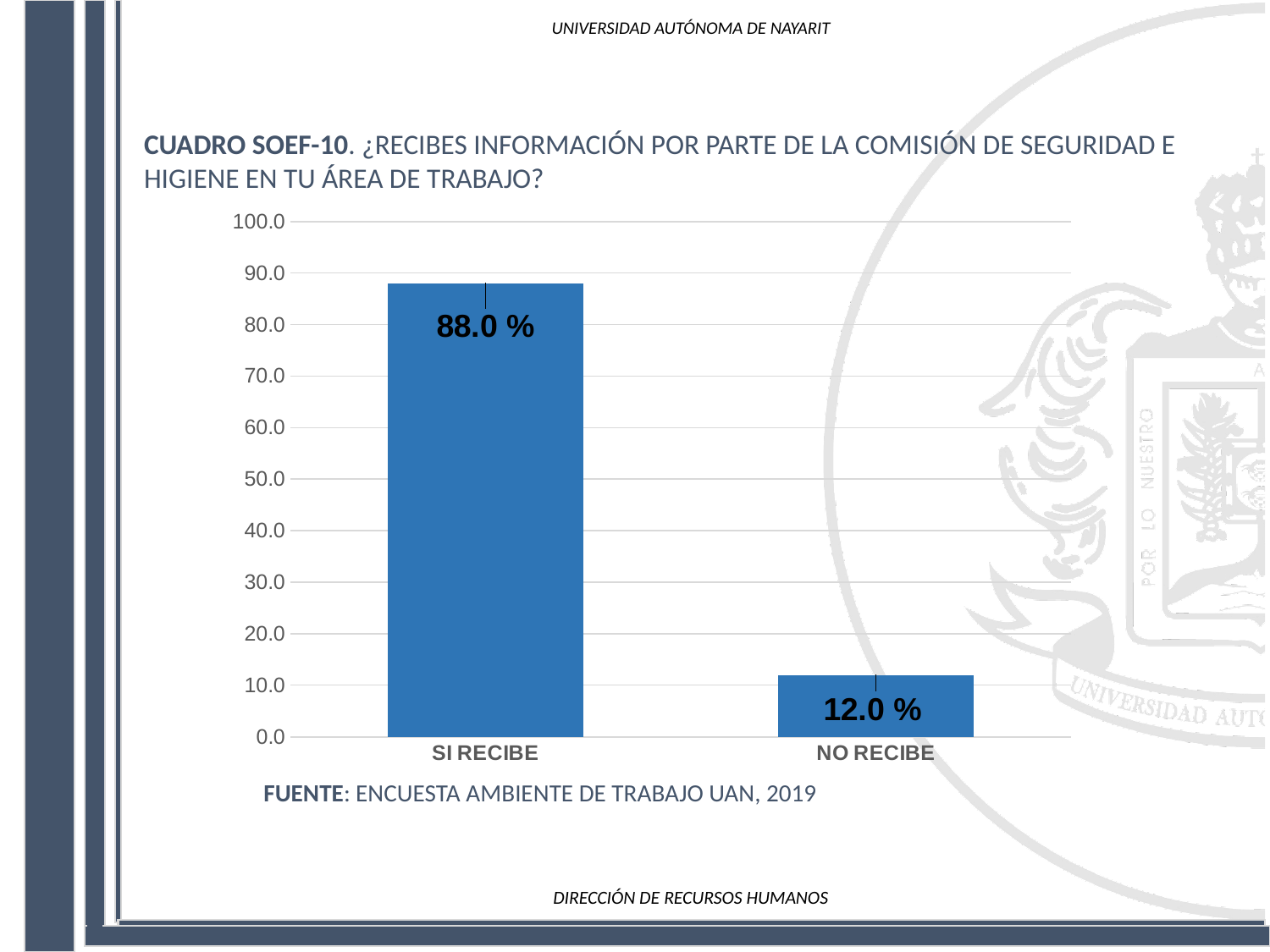
Which category has the lowest value? NO RECIBE Is the value for SI RECIBE greater or less than 80.0? greater What is the value for SI RECIBE? 88.0 % What is the difference between the values for SI RECIBE and NO RECIBE? 76.0 % What is the maximum value shown on the y axis? 100.0 Which category has the highest value? SI RECIBE What source is cited below the chart? ENCUESTA AMBIENTE DE TRABAJO UAN, 2019 What kind of chart is shown on the slide? bar chart Is the value for NO RECIBE greater or less than 20.0? less What is the value for NO RECIBE? 12.0 % How many categories are shown on the x axis? 2 Which is larger, the value for SI RECIBE or the value for NO RECIBE? SI RECIBE